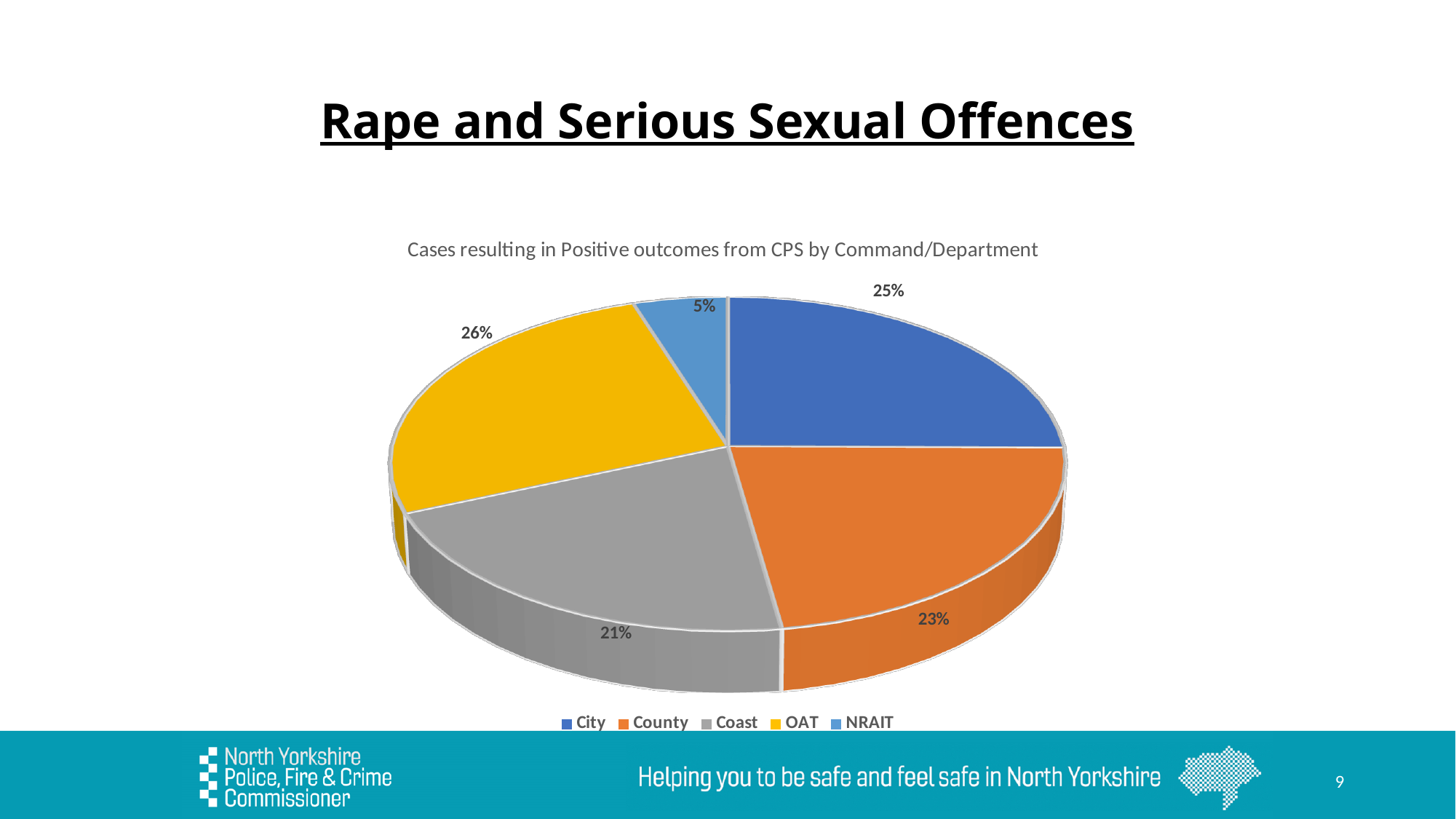
Which has a larger share, City or Coast? City What share of the pie does County account for? 23% What is the title of the chart? Cases resulting in Positive outcomes from CPS by Command/Department What share of the pie does NRAIT account for? 5% What kind of chart is shown on the slide? Pie chart What share of the pie does City account for? 25% Which command/department has the smallest share of the pie? NRAIT What share of the pie does Coast account for? 21% How many slices does the pie chart have? 5 What is the difference in percentage points between the OAT share and the NRAIT share? 21 Which command/department has the largest share of the pie? OAT What share of the pie does OAT account for? 26%